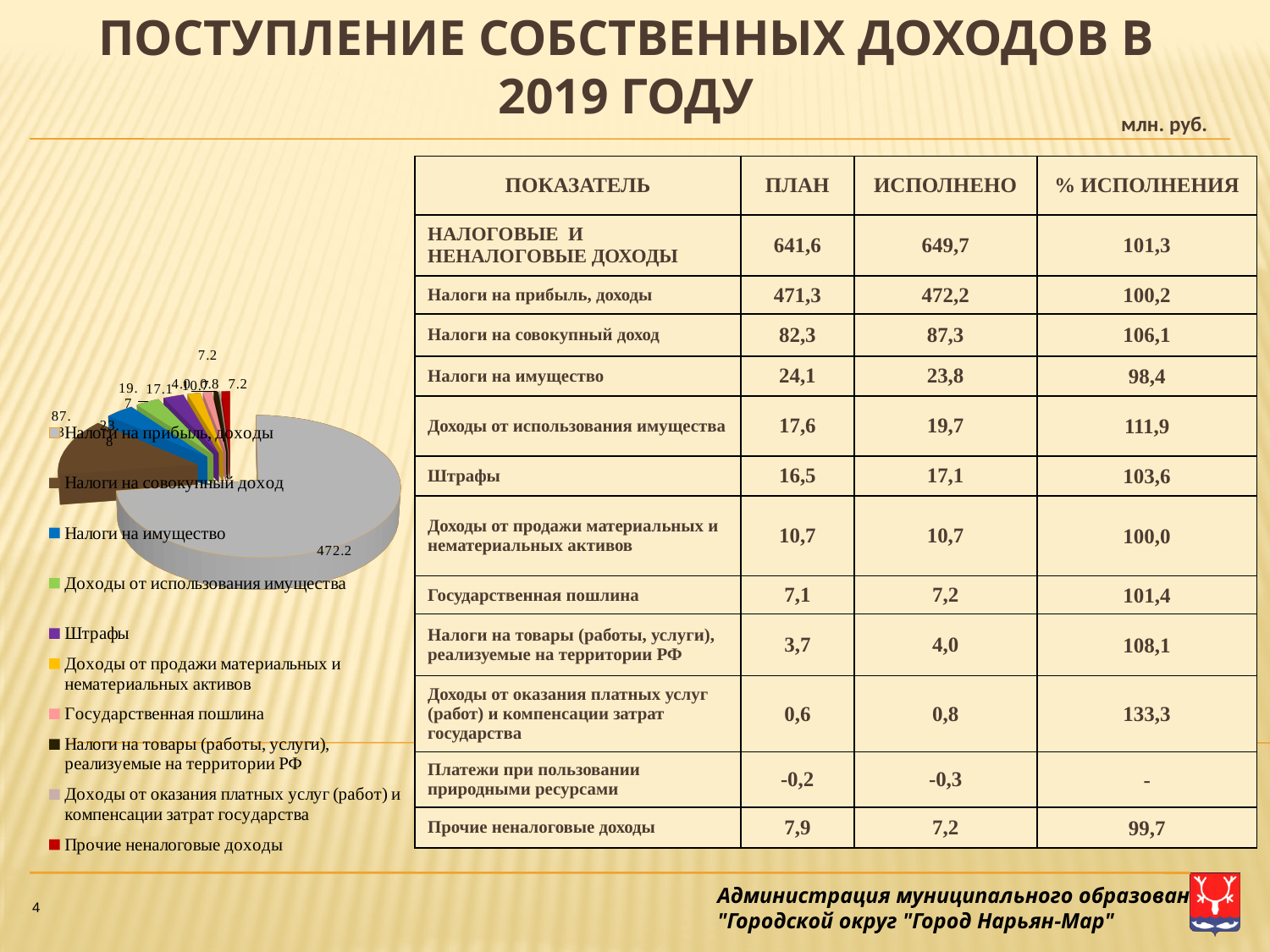
How many categories does the pie chart's legend list? 10 In the pie chart, which is larger: Налоги на прибыль, доходы or Налоги на совокупный доход? Налоги на прибыль, доходы What value is labelled on the largest slice of the pie chart? 472.2 What kind of chart is shown on the left of the slide? pie chart In the pie chart, which is larger: Налоги на совокупный доход or Штрафы? Налоги на совокупный доход Which category has the largest slice in the pie chart? Налоги на прибыль, доходы Does the largest slice of the pie chart account for more or less than half of the pie? more What is the first entry listed in the pie chart's legend? Налоги на прибыль, доходы What is the last entry listed in the pie chart's legend? Прочие неналоговые доходы